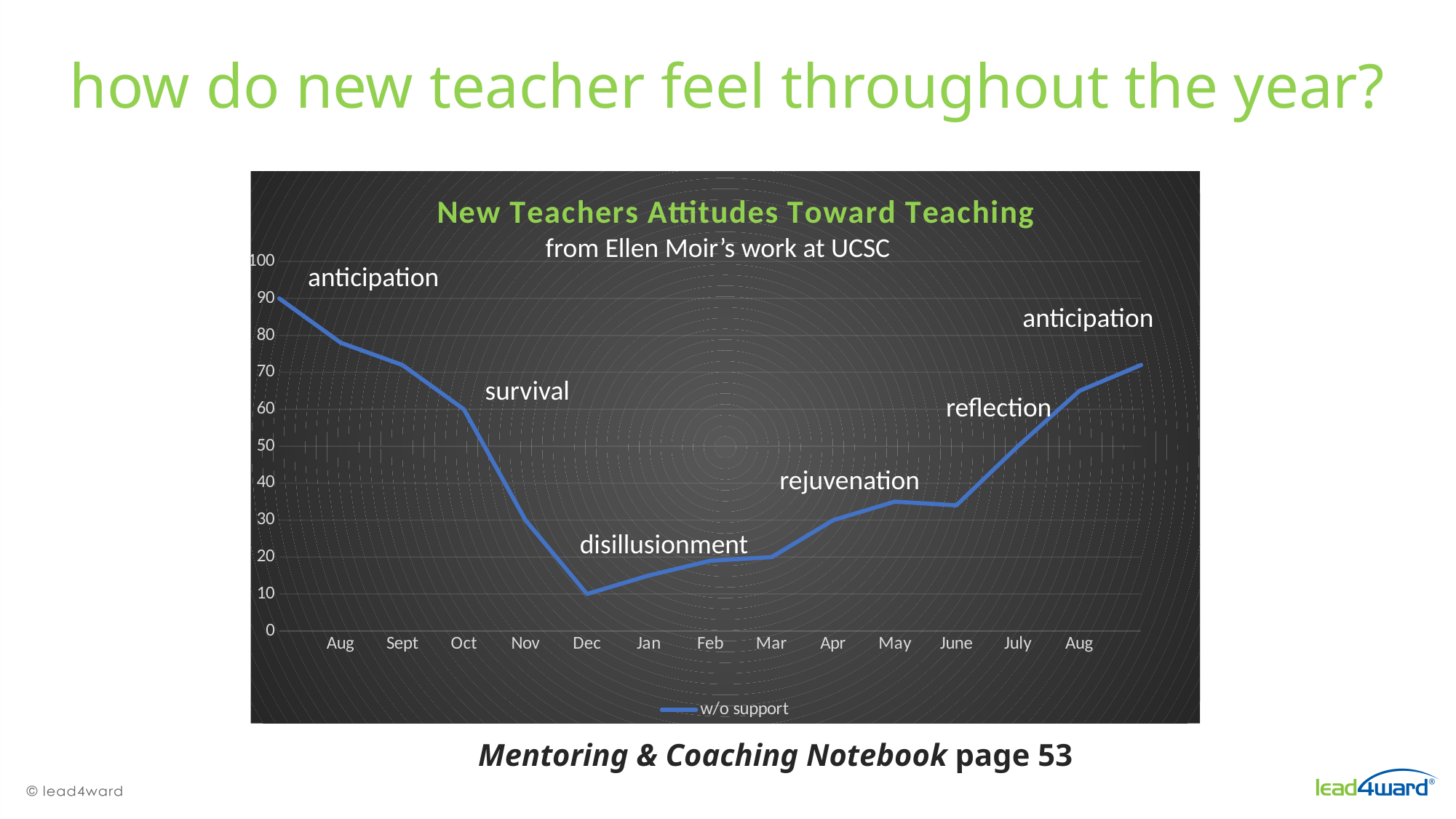
What is the name of the series in the legend? w/o support What kind of chart is shown on the slide? line chart How many month labels are shown on the x axis? 13 What is the title of the chart? New Teachers Attitudes Toward Teaching Is the value for Nov greater or less than 40? less Which is larger, the value for Oct or the value for May? Oct What is the value for Dec? 10 Which month has the lowest value on the line? Dec Is the value for July greater or less than 40? greater Is the value for Jan greater or less than 20? less How many series does the chart legend list? 1 Does the line rise or fall from Dec to July? rise